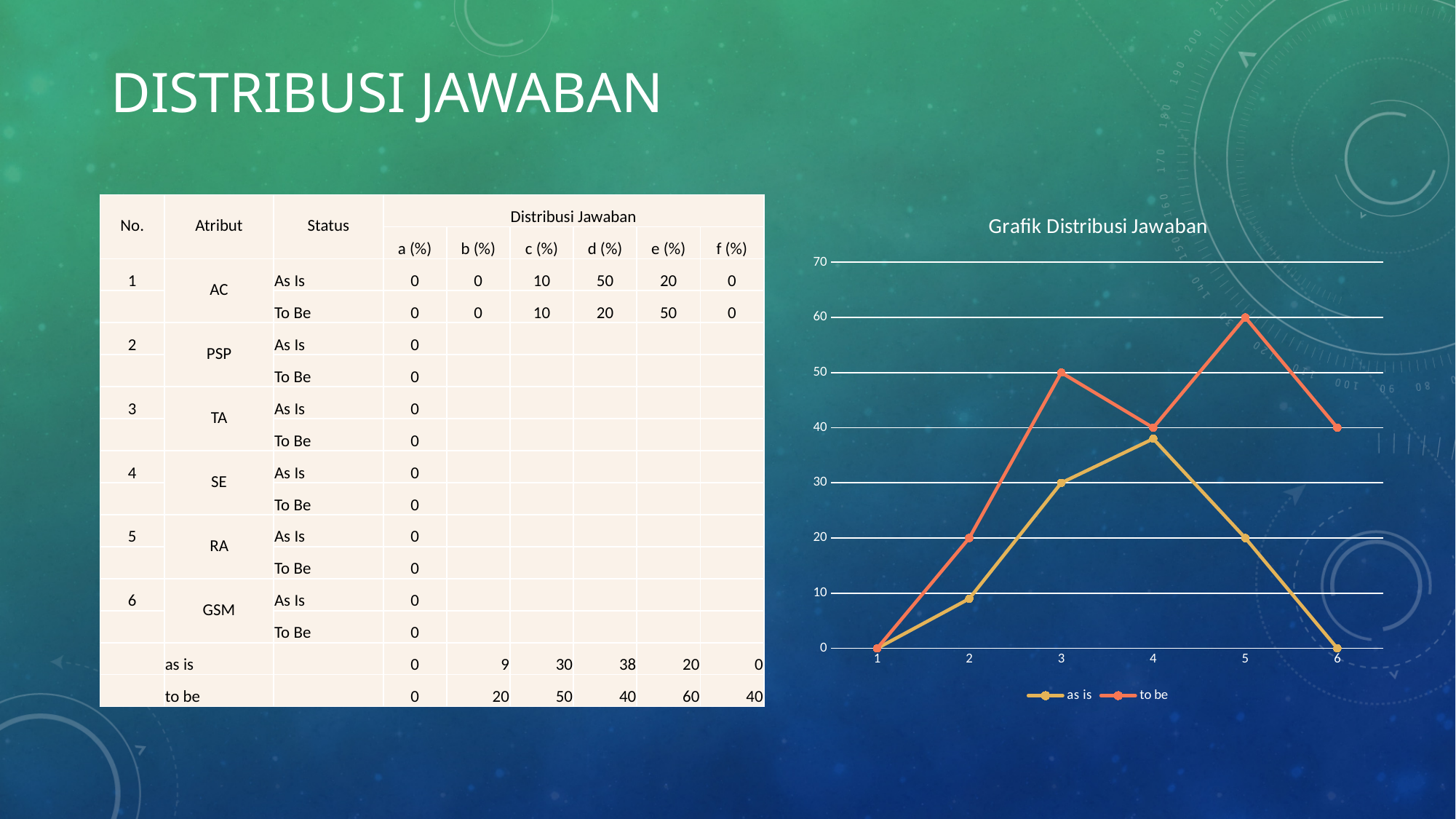
At which x value does the "to be" series reach its highest point? 5 Which series is higher at x = 6, "as is" or "to be"? to be What is the value of the "to be" series at x = 3? 50 What is the difference between the "to be" and "as is" values at x = 5? 40 At which x value does the "as is" series reach its highest point? 4 What is the value of the "as is" series at x = 3? 30 What kind of chart is shown on the slide? line chart What is the title of the chart on the slide? Grafik Distribusi Jawaban How many points are plotted along the x axis for each series in the chart? 6 How many series does the chart's legend list? 2 What is the value of the "to be" series at x = 5? 60 Is the value of the "as is" series at x = 2 greater or less than 10? less